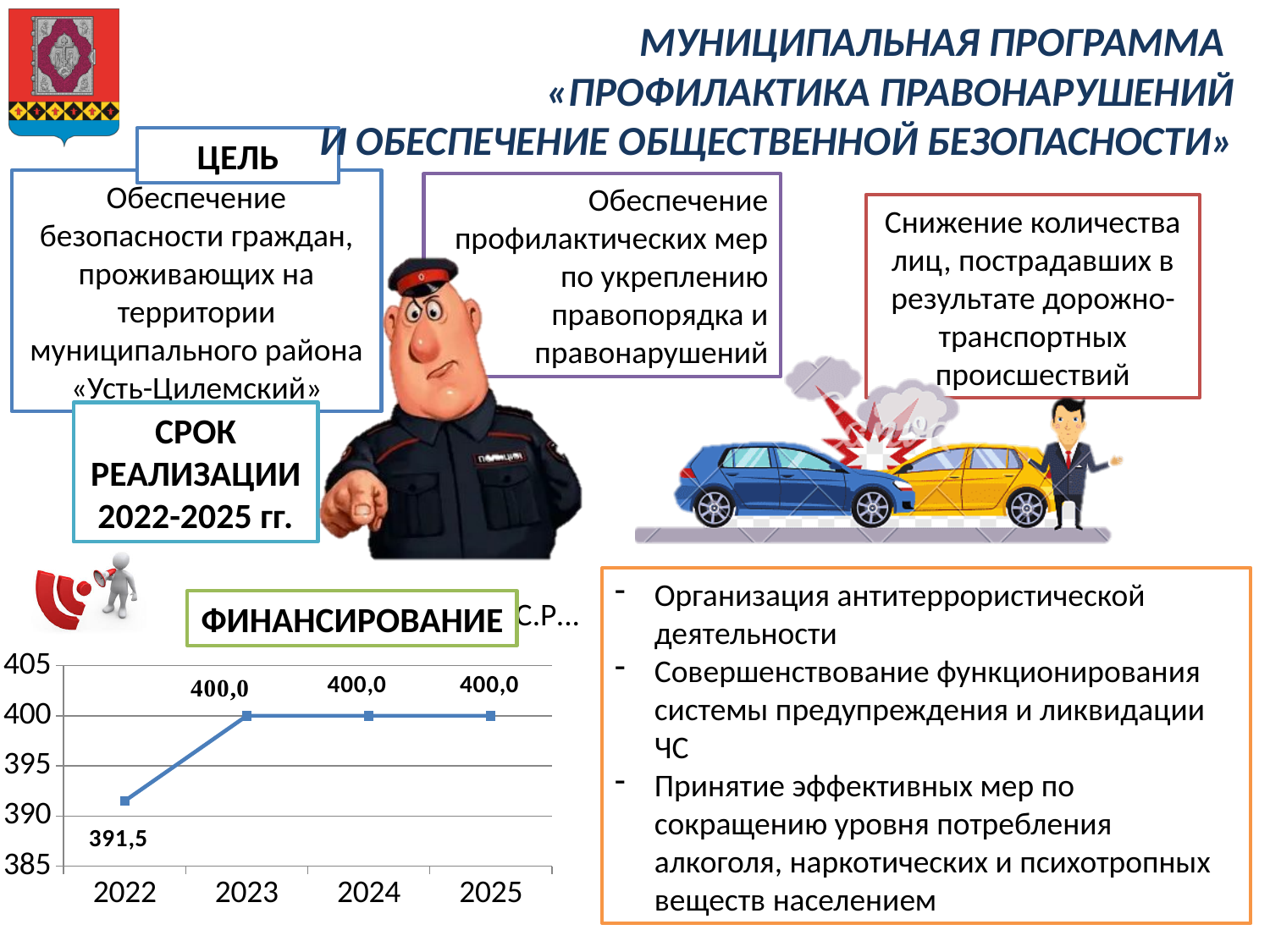
Which is larger on the line chart, the value for 2022 or the value for 2024? 2024 What kind of chart is shown under the heading ФИНАНСИРОВАНИЕ? line chart Is the value for 2022 on the line chart greater or less than 395? less Do the values on the line chart change between 2023 and 2025? No, they stay at 400,0 What is the value for 2023 on the line chart? 400,0 What is the value for 2022 on the line chart? 391,5 What is the difference between the values for 2023 and 2022 on the line chart? 8,5 Does the value on the line chart rise or fall from 2022 to 2023? rise What is the value for 2025 on the line chart? 400,0 Which year has the lowest value on the line chart? 2022 How many years are plotted on the line chart? 4 What is the lowest tick value shown on the vertical axis of the line chart? 385